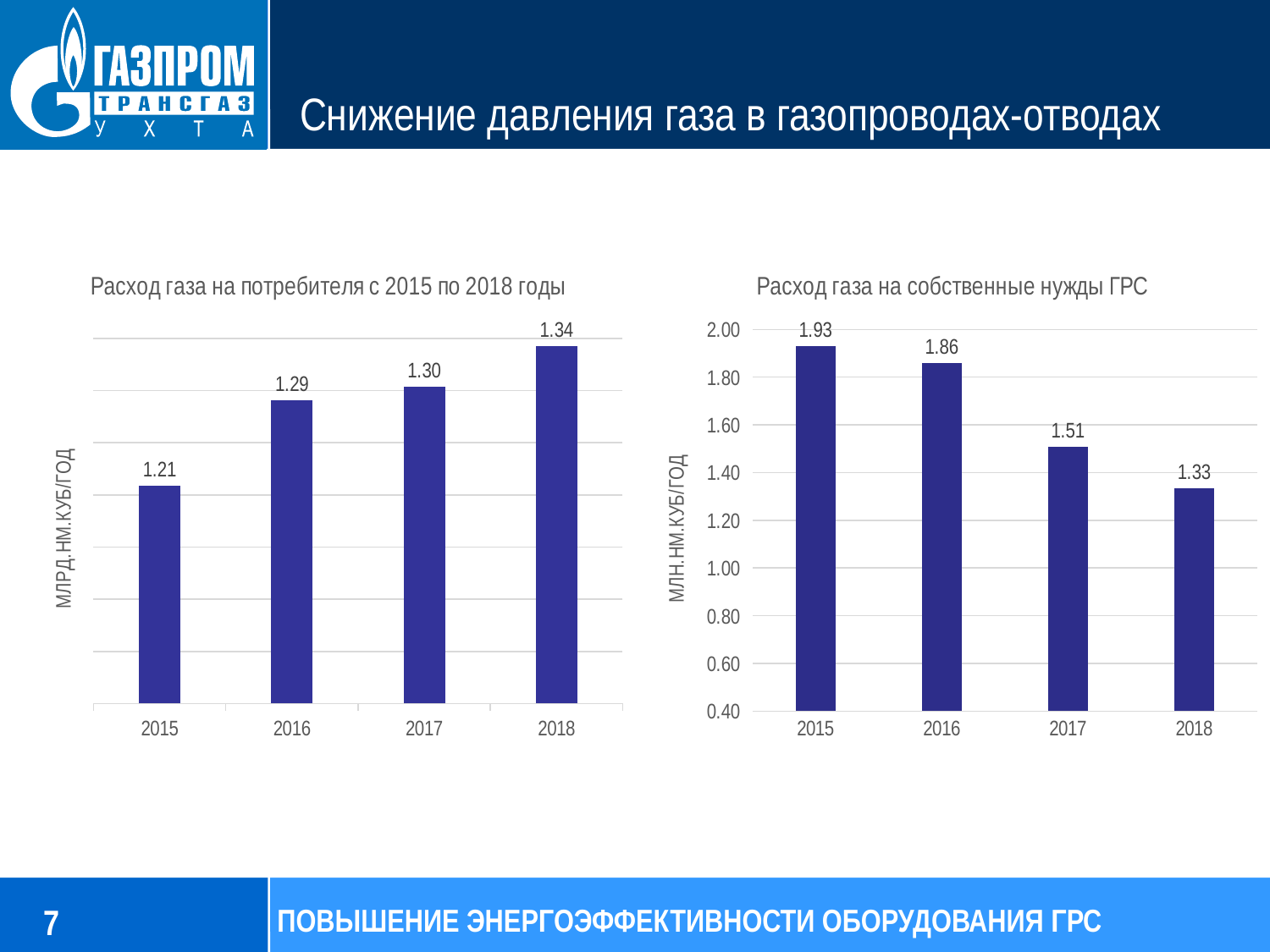
In the chart 'Расход газа на собственные нужды ГРС', what is the difference between the values for 2015 and 2018? 0.60 In the chart 'Расход газа на потребителя с 2015 по 2018 годы', which year has the highest value? 2018 In the chart 'Расход газа на потребителя с 2015 по 2018 годы', what is the value for 2016? 1.29 What kind of chart is 'Расход газа на собственные нужды ГРС'? bar chart In the chart 'Расход газа на собственные нужды ГРС', what is the value for 2017? 1.51 In the chart 'Расход газа на собственные нужды ГРС', which year has the lowest value? 2018 How many years are shown on the x axis of the chart 'Расход газа на потребителя с 2015 по 2018 годы'? 4 In the chart 'Расход газа на собственные нужды ГРС', is the value for 2015 greater or less than 1.80? greater In the chart 'Расход газа на собственные нужды ГРС', do the values rise or fall from 2015 to 2018? fall In the chart 'Расход газа на потребителя с 2015 по 2018 годы', what is the difference between the values for 2018 and 2015? 0.13 What is the y-axis label of the chart 'Расход газа на потребителя с 2015 по 2018 годы'? МЛРД.НМ.КУБ/ГОД In the chart 'Расход газа на собственные нужды ГРС', which is larger, the value for 2016 or the value for 2017? 2016